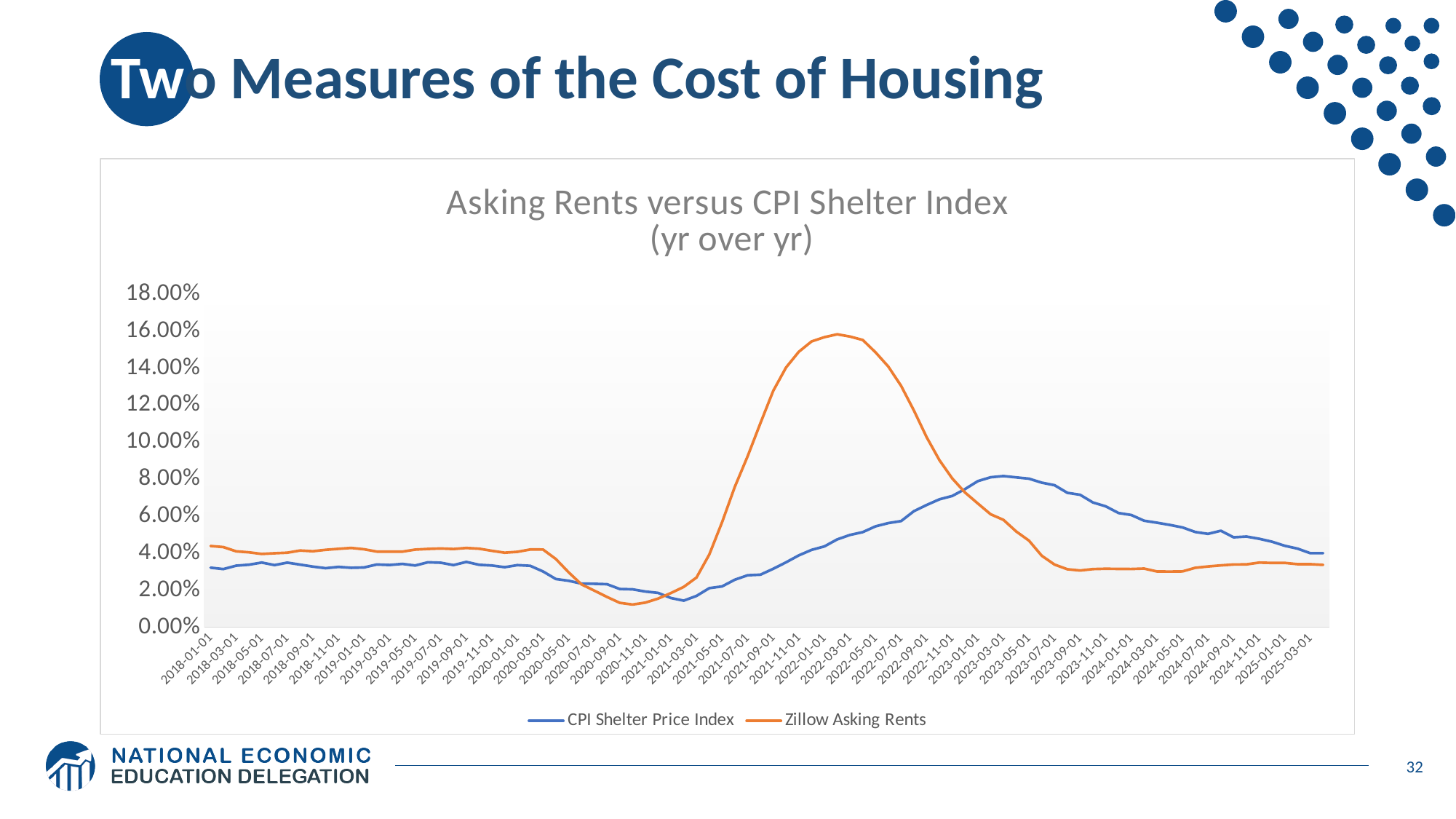
Which series reaches the highest peak on the chart? Zillow Asking Rents At 2022-03-01, which series has the higher value, CPI Shelter Price Index or Zillow Asking Rents? Zillow Asking Rents What is the title of the chart? Asking Rents versus CPI Shelter Index (yr over yr) At 2023-09-01, which series has the higher value, CPI Shelter Price Index or Zillow Asking Rents? CPI Shelter Price Index How many series does the legend list? 2 What kind of chart is shown on the slide? Line chart Is the value for CPI Shelter Price Index at 2018-01-01 greater or less than 4.00%? less Is the value for Zillow Asking Rents at 2020-11-01 greater or less than 2.00%? less Which series is drawn in orange? Zillow Asking Rents Is the value for CPI Shelter Price Index at 2023-03-01 greater or less than 6.00%? greater Does the Zillow Asking Rents line rise or fall between 2022-03-01 and 2023-09-01? Fall